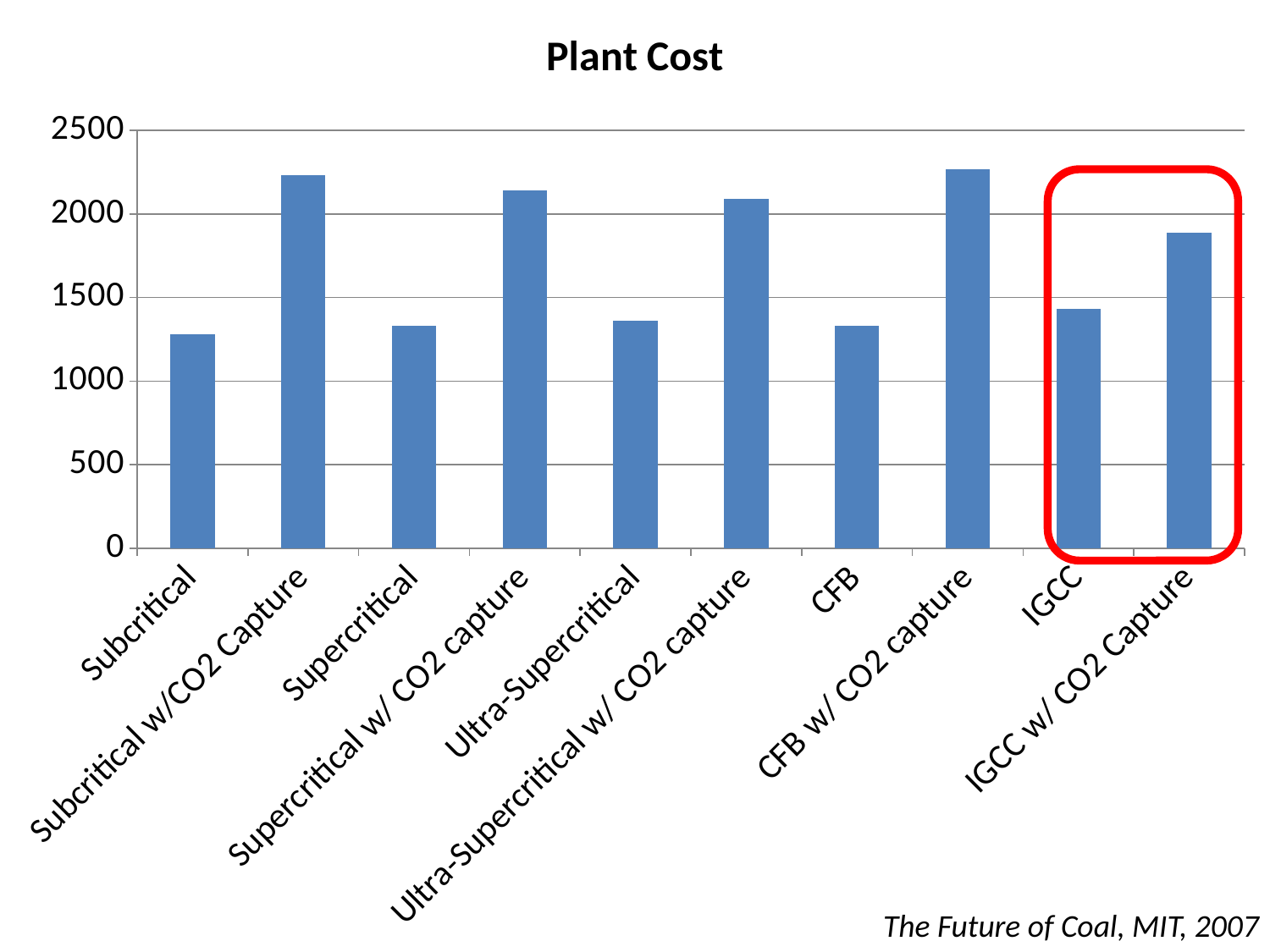
Is the value for IGCC w/ CO2 Capture greater or less than 2000? less Is the value for Subcritical greater or less than 1500? less What is the title of the chart? Plant Cost Is the value for IGCC greater or less than 1500? less Which is larger, the value for IGCC w/ CO2 Capture or the value for Subcritical w/CO2 Capture? Subcritical w/CO2 Capture How many categories are plotted in the Plant Cost chart? 10 Which is larger, the value for IGCC or the value for Subcritical? IGCC What type of chart is shown on the slide? bar chart Which two categories are enclosed by the red box on the chart? IGCC and IGCC w/ CO2 Capture